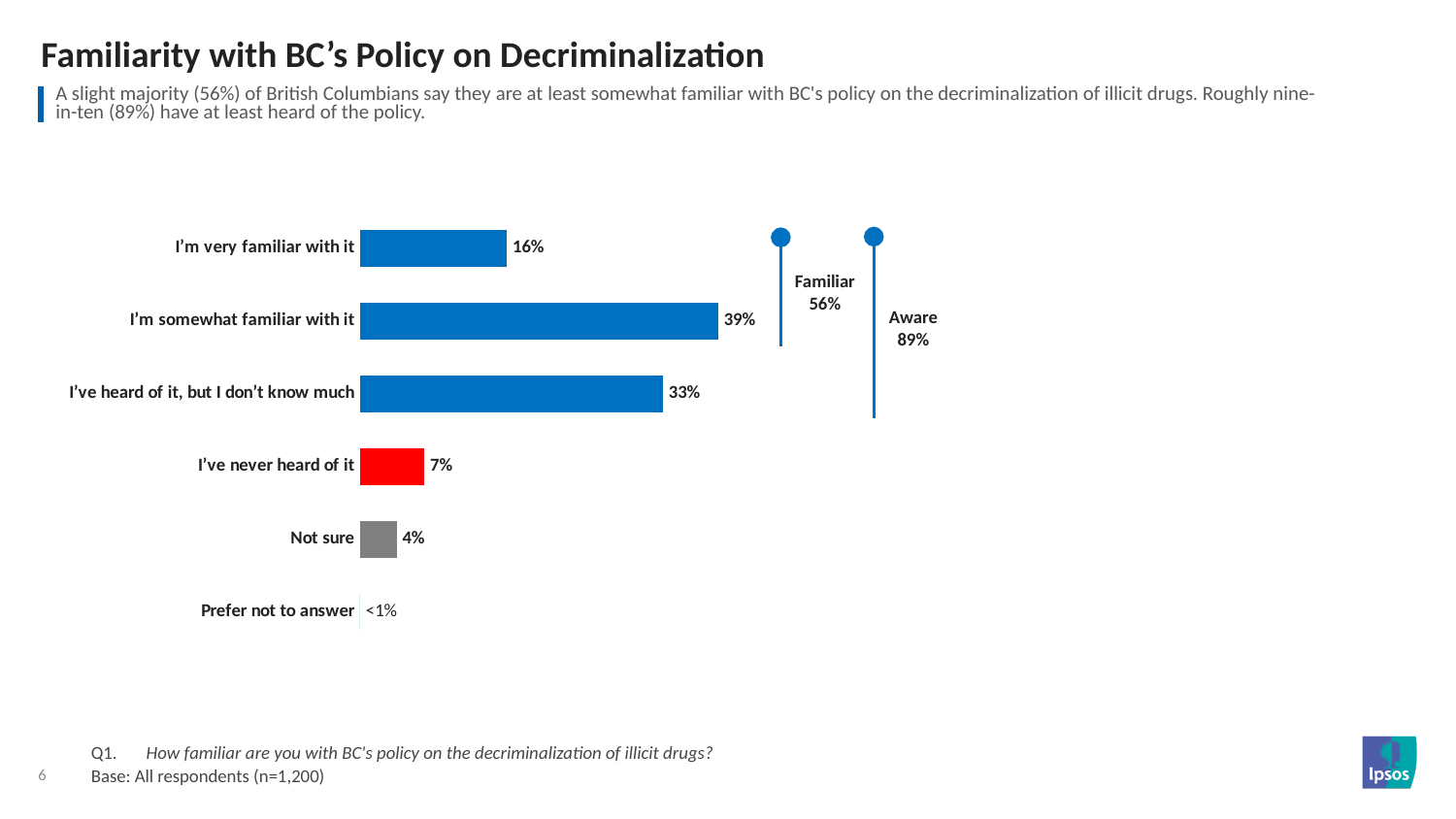
What type of chart is used on this slide? Bar chart What percentage of respondents say they have never heard of the policy? 7% What percentage of respondents say they are somewhat familiar with BC's policy on decriminalization? 39% Which response category has the lowest percentage? Prefer not to answer How many response categories are shown in the chart? 6 What is the difference between the percentage who are somewhat familiar and the percentage who are very familiar? 23% What combined percentage is labelled 'Familiar' on the chart? 56% What percentage of respondents say they are very familiar with the policy? 16% Which is larger: the percentage who have heard of it but don't know much, or the percentage who are very familiar with it? I've heard of it, but I don't know much Which response category has the highest percentage? I'm somewhat familiar with it What colour is the bar for 'I've never heard of it'? Red What value is shown for 'Prefer not to answer'? <1%